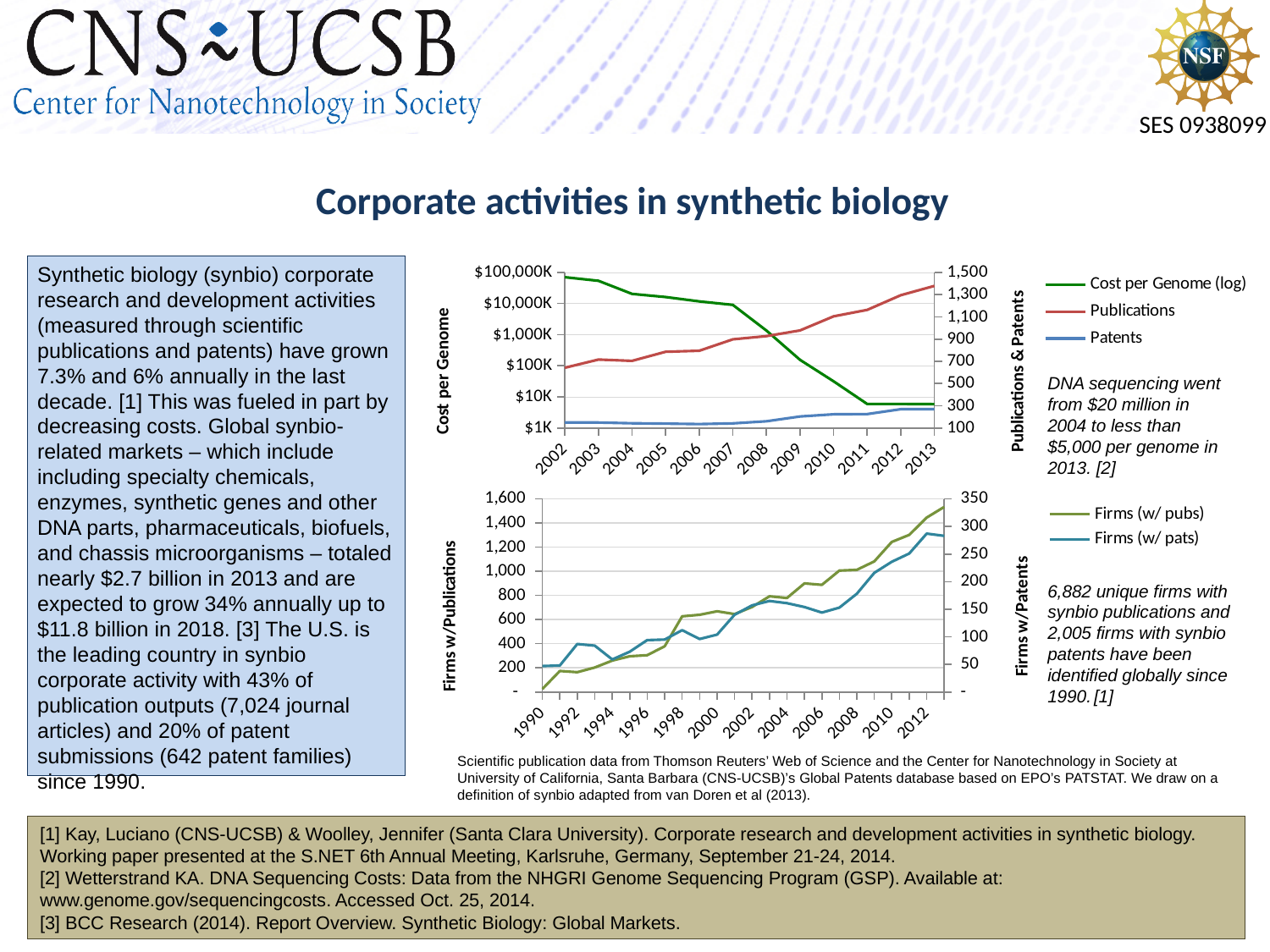
What is the title of the left vertical axis of the bottom chart? Firms w/Publications How many years are labelled on the x axis of the top chart? 12 In the top chart, is the Cost per Genome in 2013 greater or less than $10K? less In the top chart, is the value for Publications in 2013 greater or less than 1,100? greater How many series does the legend of the bottom chart list? 2 In the top chart, which series has the higher value in 2013, Publications or Patents? Publications In the top chart, does the Publications line rise or fall from 2002 to 2013? Rise In the bottom chart, is the value for Firms (w/ pubs) in 2012 greater or less than 1,400? greater What kind of chart is the top chart on the slide? Line chart In the top chart, does the Cost per Genome line rise or fall from 2002 to 2013? Fall How many series does the legend of the top chart list? 3